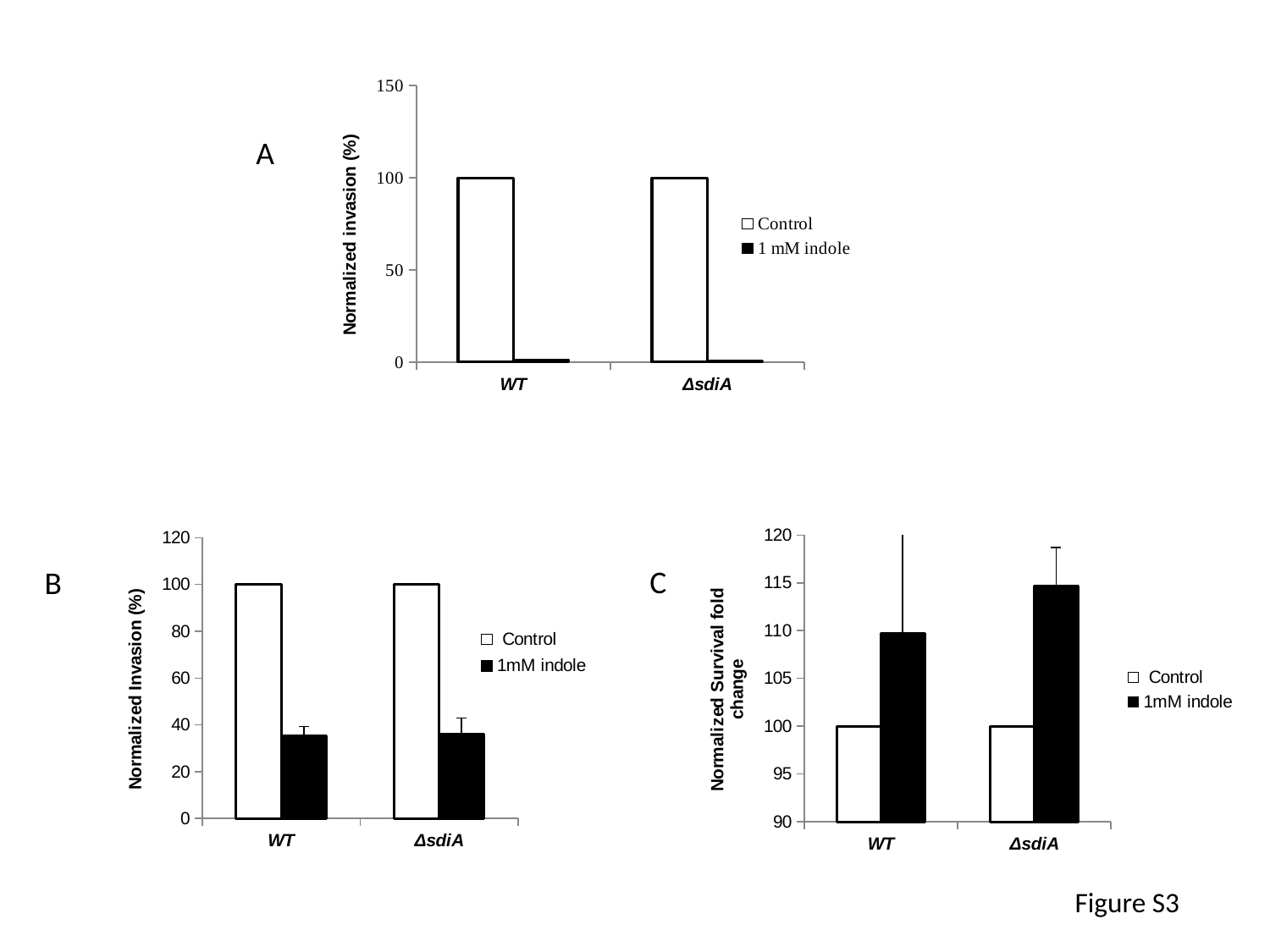
In chart C, what is the value of the Control bar for WT? 100 In chart B, which is larger for WT: the Control bar or the 1mM indole bar? Control What kind of chart is chart C? bar chart In chart B, what is the value of the Control bar for ΔsdiA? 100 In chart B, is the value for 1mM indole in ΔsdiA greater or less than 20? greater In chart A, is the value for 1 mM indole in WT greater or less than 50? less In chart C, is the value for 1mM indole in ΔsdiA greater or less than 110? greater In chart A, how many series does the legend list? 2 In chart A, what is the value of the Control bar for WT? 100 In chart C, which category has the higher 1mM indole bar, WT or ΔsdiA? ΔsdiA In chart C, how many categories are shown on the x axis? 2